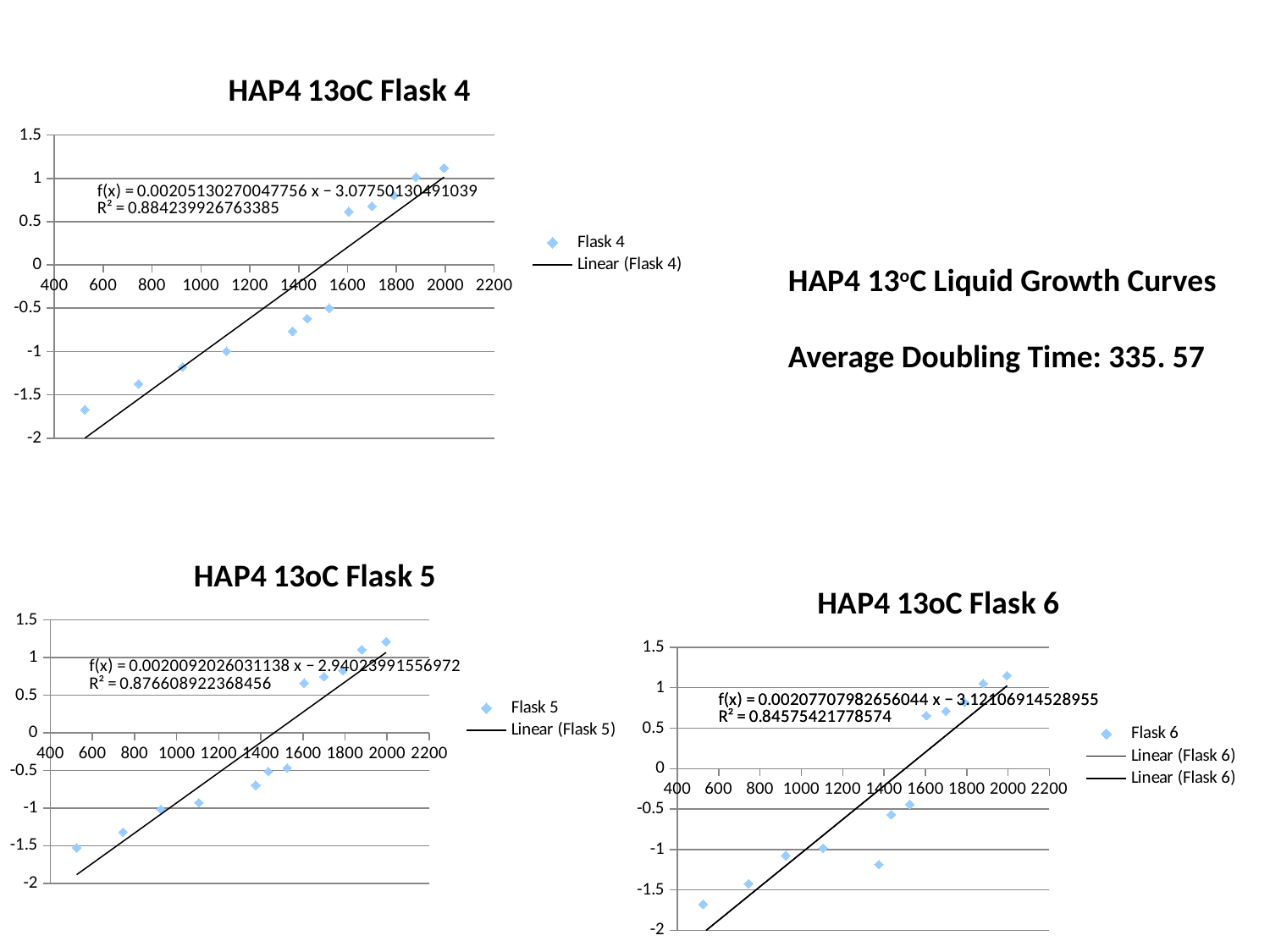
On the HAP4 13oC Flask 4 chart, is the value of the leftmost data point greater or less than -1.5? less How many entries does the legend of the HAP4 13oC Flask 5 chart list? 2 How many entries does the legend of the HAP4 13oC Flask 6 chart list? 3 On the HAP4 13oC Flask 5 chart, is the value of the rightmost data point greater or less than 1? greater What kind of chart is the HAP4 13oC Flask 4 chart? scatter chart Which of the three charts shows the highest R² value? HAP4 13oC Flask 4 On the HAP4 13oC Flask 6 chart, what is the R² value shown for the linear fit? 0.84575421778574 On the HAP4 13oC Flask 5 chart, what is the R² value shown for the linear fit? 0.876608922368456 On the HAP4 13oC Flask 4 chart, do the Flask 4 values rise or fall as x increases? rise On the HAP4 13oC Flask 4 chart, what is the R² value shown for the linear fit? 0.884239926763385 On the HAP4 13oC Flask 6 chart, do the Flask 6 values rise or fall as x increases? rise Which of the three charts shows the lowest R² value? HAP4 13oC Flask 6